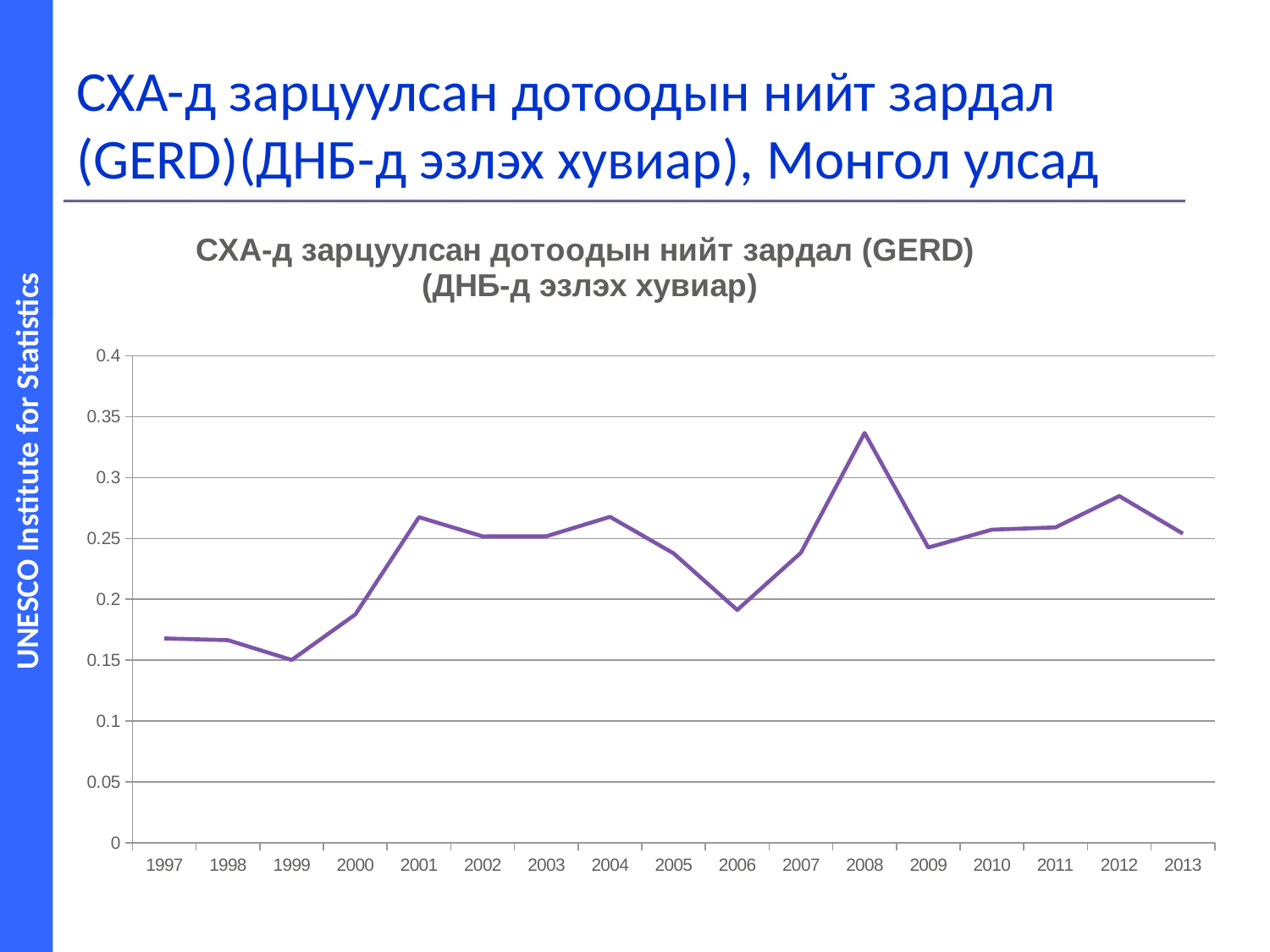
Is the value for 1997 greater or less than 0.2? less How many years are plotted along the x axis of the chart? 17 Which year has the larger value, 2008 or 2009? 2008 Does the value rise or fall from 1999 to 2001? rise In which year is the GERD value lowest? 1999 Which year has the larger value, 2000 or 2001? 2001 Is the value for 2006 greater or less than 0.2? less What is the first year shown on the x axis of the chart? 1997 Is the value for 2001 greater or less than 0.25? greater In which year is the GERD value highest? 2008 What kind of chart is shown on the slide? line chart